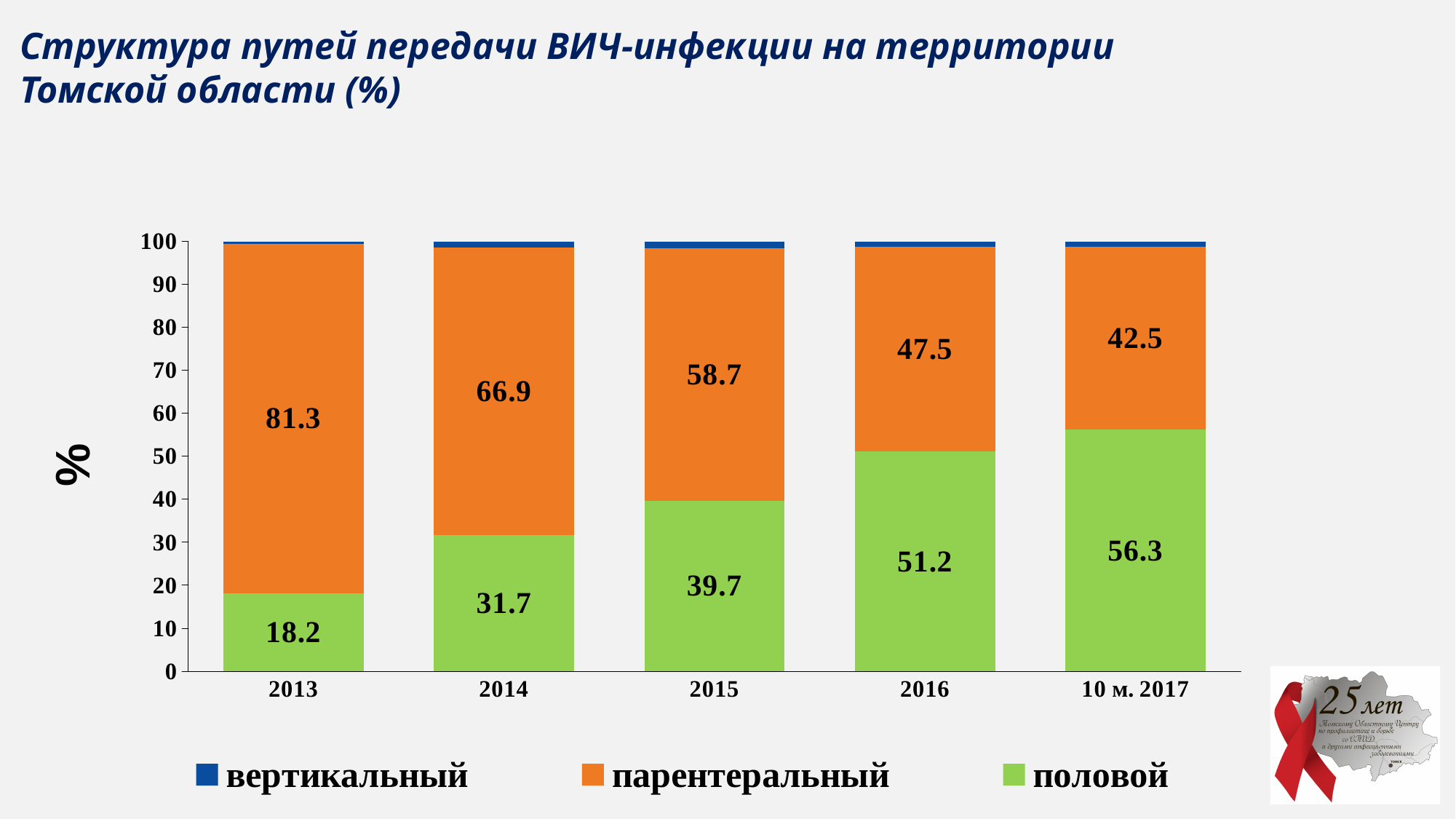
Does the половой value rise or fall from 2013 to 10 м. 2017? rise In which year is the парентеральный value highest? 2013 How many categories are shown on the x axis? 5 What is the value for половой in 10 м. 2017? 56.3 Is the value for половой in 2015 greater or less than 50? less How many series does the legend list? 3 What is the value for половой in 2013? 18.2 What is the value for парентеральный in 2015? 58.7 What is the difference between the парентеральный values in 2013 and 2014? 14.4 In which category is the половой value lowest? 2013 Which is larger in 2016: половой or парентеральный? половой What kind of chart is shown on the slide? stacked bar chart